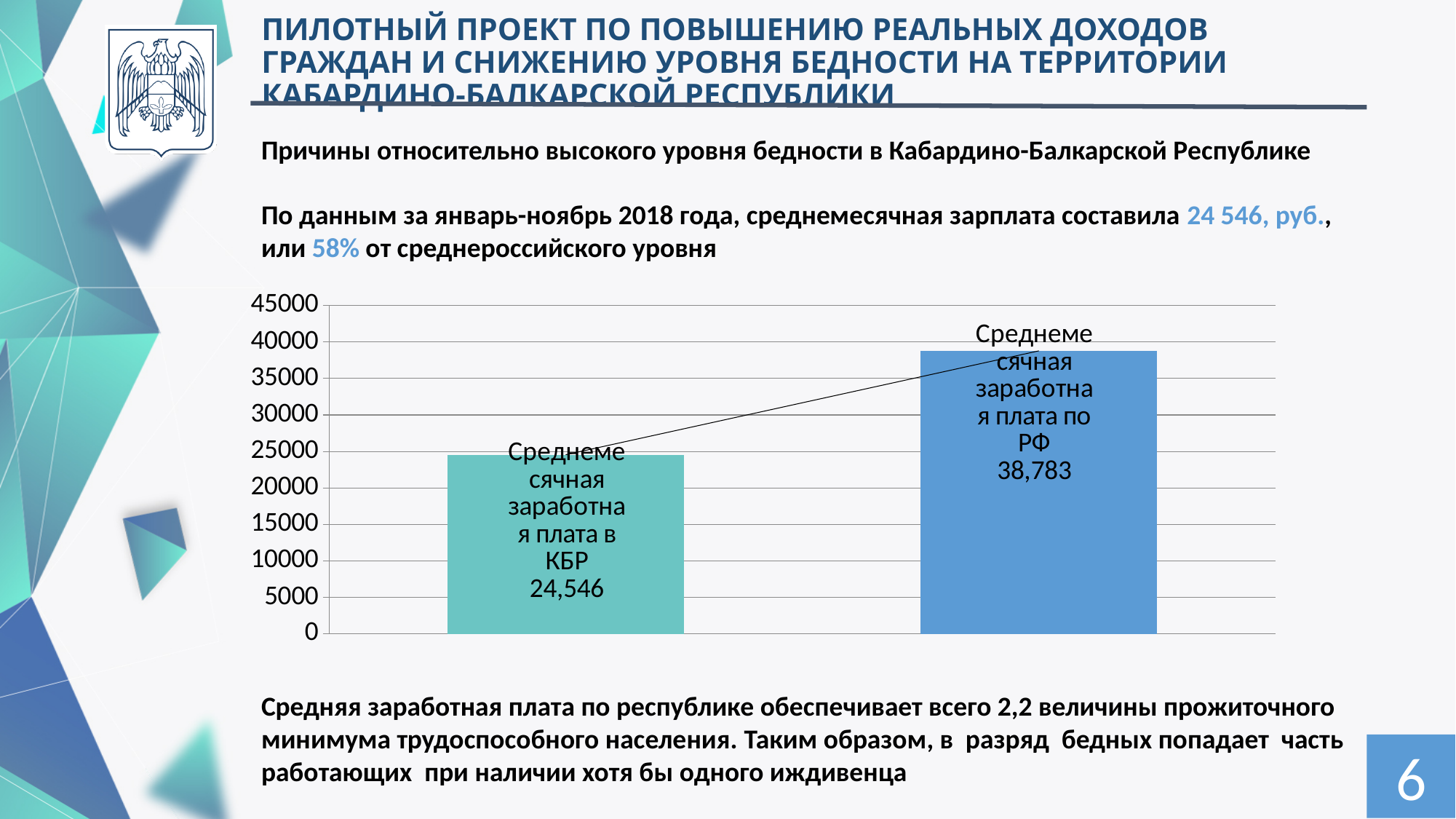
Is the value for the average monthly salary in the Russian Federation greater or less than 35000? greater Which bar is higher: the average monthly salary in KBR or in the Russian Federation? Russian Federation (по РФ) Is the value for the average monthly salary in KBR greater or less than 25000? less Which category has the highest value on the chart? Среднемесячная заработная плата по РФ What is the value shown for the average monthly salary in the Russian Federation (Среднемесячная заработная плата по РФ)? 38,783 What colour is the bar for the average monthly salary in KBR? Teal (light green-blue) Which category has the lowest value on the chart? Среднемесячная заработная плата в КБР How many bars are plotted on the chart? 2 What is the maximum value shown on the vertical axis of the chart? 45000 What is the value shown for the average monthly salary in KBR (Среднемесячная заработная плата в КБР)? 24,546 What type of chart is shown on the slide? Bar chart What is the difference between the average monthly salary in the Russian Federation and in KBR? 14,237